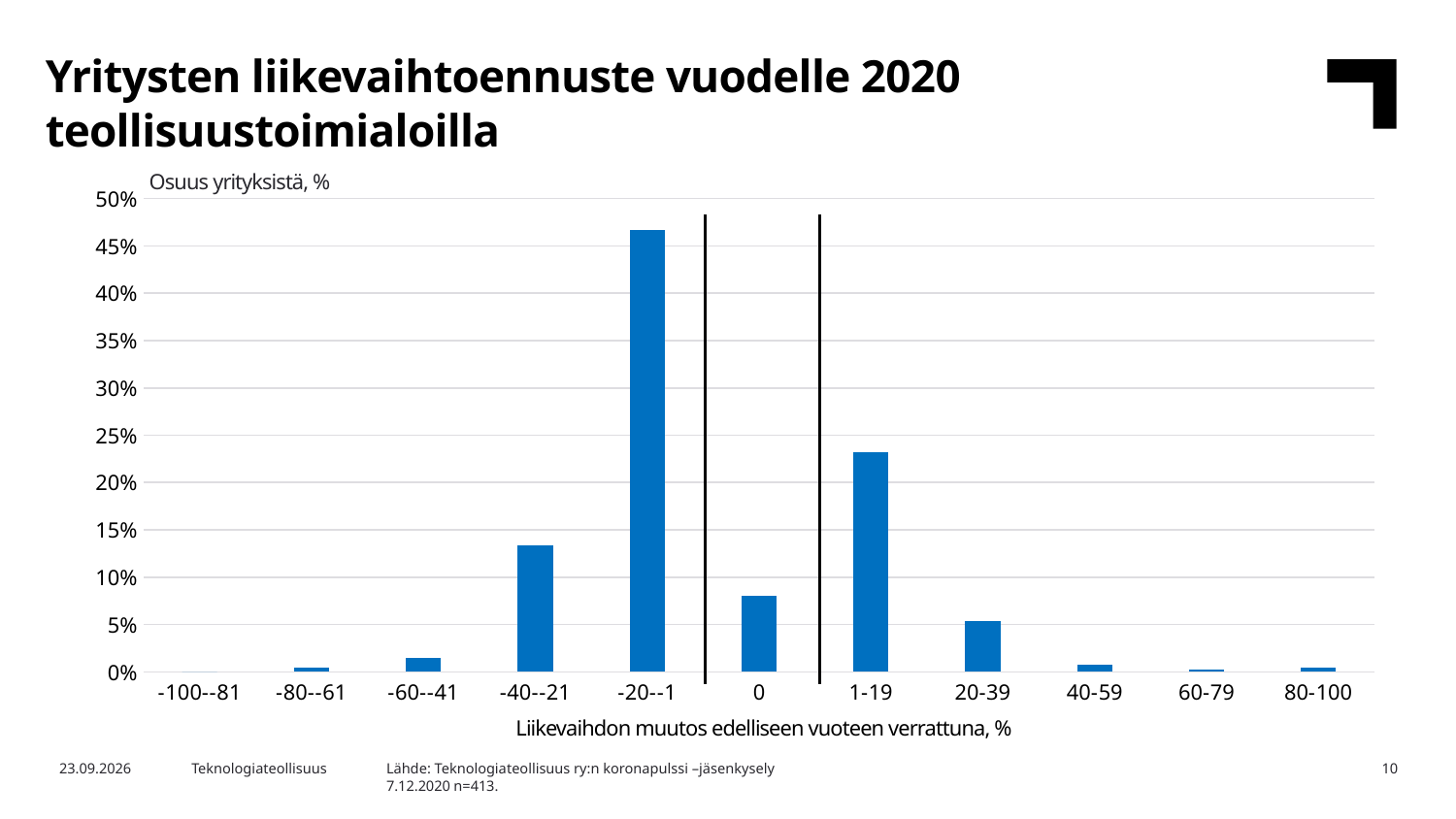
How many categories are shown on the x axis? 11 Is the value for the -40--21 category greater or less than 15%? less Is the value for the -20--1 category greater or less than 45%? greater Which is larger, the value for 1-19 or the value for -40--21? 1-19 Which category has the highest share of companies? -20--1 What is the label of the x axis? Liikevaihdon muutos edelliseen vuoteen verrattuna, % Which is larger, the value for 0 or the value for 20-39? 0 What is the title of the chart? Yritysten liikevaihtoennuste vuodelle 2020 teollisuustoimialoilla Is the value for the 0 category greater or less than 10%? less What kind of chart is shown on the slide? bar chart